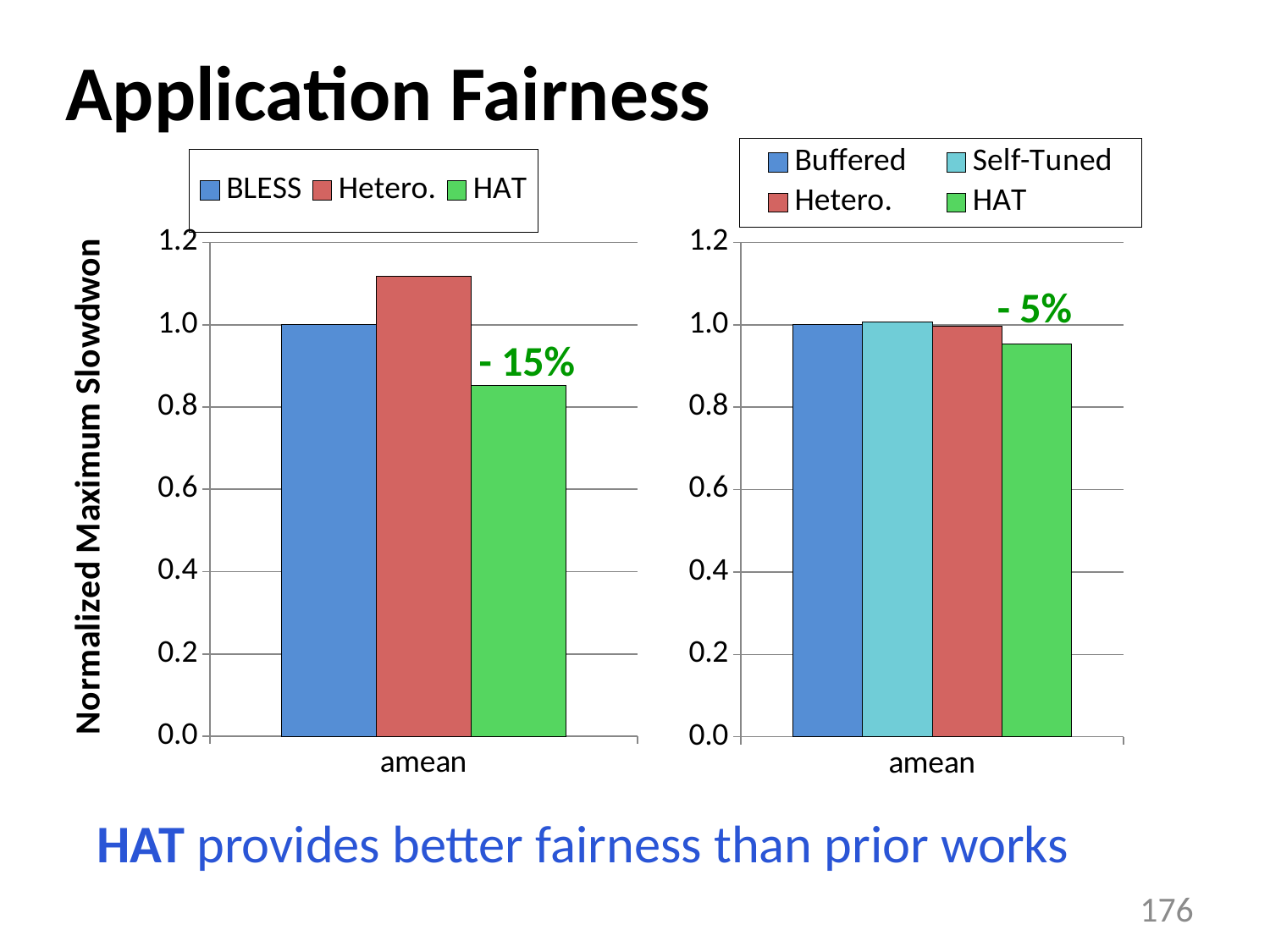
In the left chart, is the value for HAT greater or less than 0.8? greater What percentage reduction is annotated next to the HAT bar in the right chart? - 5% How many series does the legend of the left chart list? 3 What kind of chart is the left chart (BLESS / Hetero. / HAT)? bar chart In the left chart, which series has the lowest normalized maximum slowdown for amean? HAT In the left chart, which is larger, the value for BLESS or the value for Hetero.? Hetero. In the left chart, what is the normalized maximum slowdown for BLESS? 1.0 In the left chart, which series has the highest normalized maximum slowdown for amean? Hetero. In the right chart, which series has the lowest normalized maximum slowdown for amean? HAT In the left chart, is the value for Hetero. greater or less than 1.0? greater How many series does the legend of the right chart list? 4 In the right chart, is the value for HAT greater or less than 1.0? less